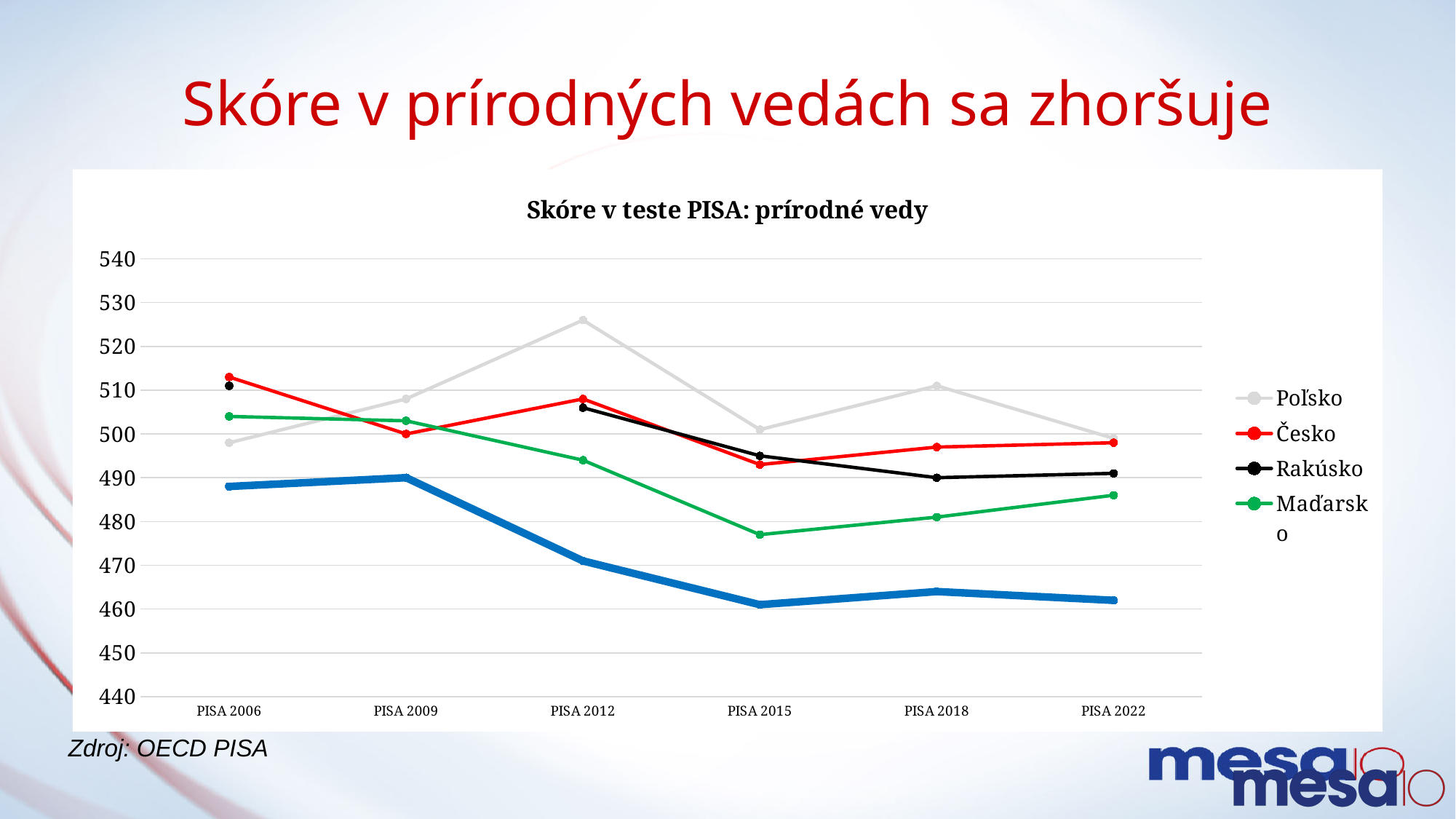
How many PISA rounds are shown on the x axis? 6 Is the value for Maďarsko at PISA 2015 greater or less than 480? less What is the title of the chart? Skóre v teste PISA: prírodné vedy At PISA 2022, which is higher: Česko or Rakúsko? Česko Among the series listed in the legend, which has the lowest value at PISA 2015? Maďarsko At PISA 2006, which is higher: Poľsko or Česko? Česko How many series does the legend list? 4 Which series reaches the highest value anywhere on the chart? Poľsko Is the value for Česko at PISA 2015 greater or less than 500? less Does the value for Maďarsko rise or fall from PISA 2006 to PISA 2015? fall What kind of chart is shown on the slide? line chart Is the value for Poľsko at PISA 2012 greater or less than 520? greater